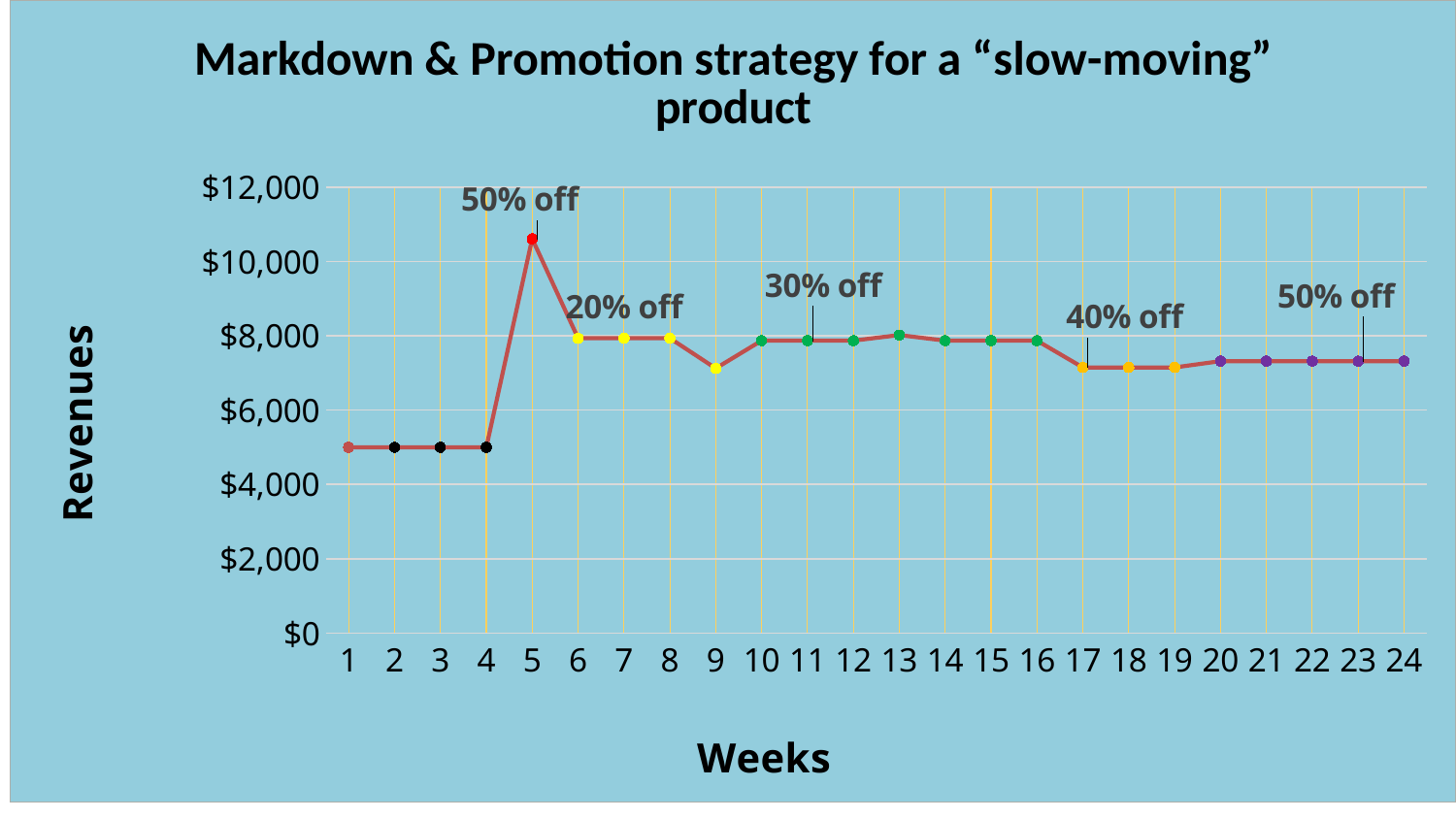
Which has the higher revenue, week 4 or week 17? Week 17 Which has the higher revenue, week 5 or week 10? Week 5 Is the revenue for week 20 greater or less than $8,000? less Which week has the highest revenue? Week 5 Do revenues rise or fall from week 5 to week 9? fall What discount is annotated at week 17? 40% off How many weeks are plotted on the x axis? 24 What is the label of the y axis? Revenues Is the revenue for week 5 greater or less than $10,000? greater Is the revenue for week 9 greater or less than $8,000? less What kind of chart is shown on the slide? line chart